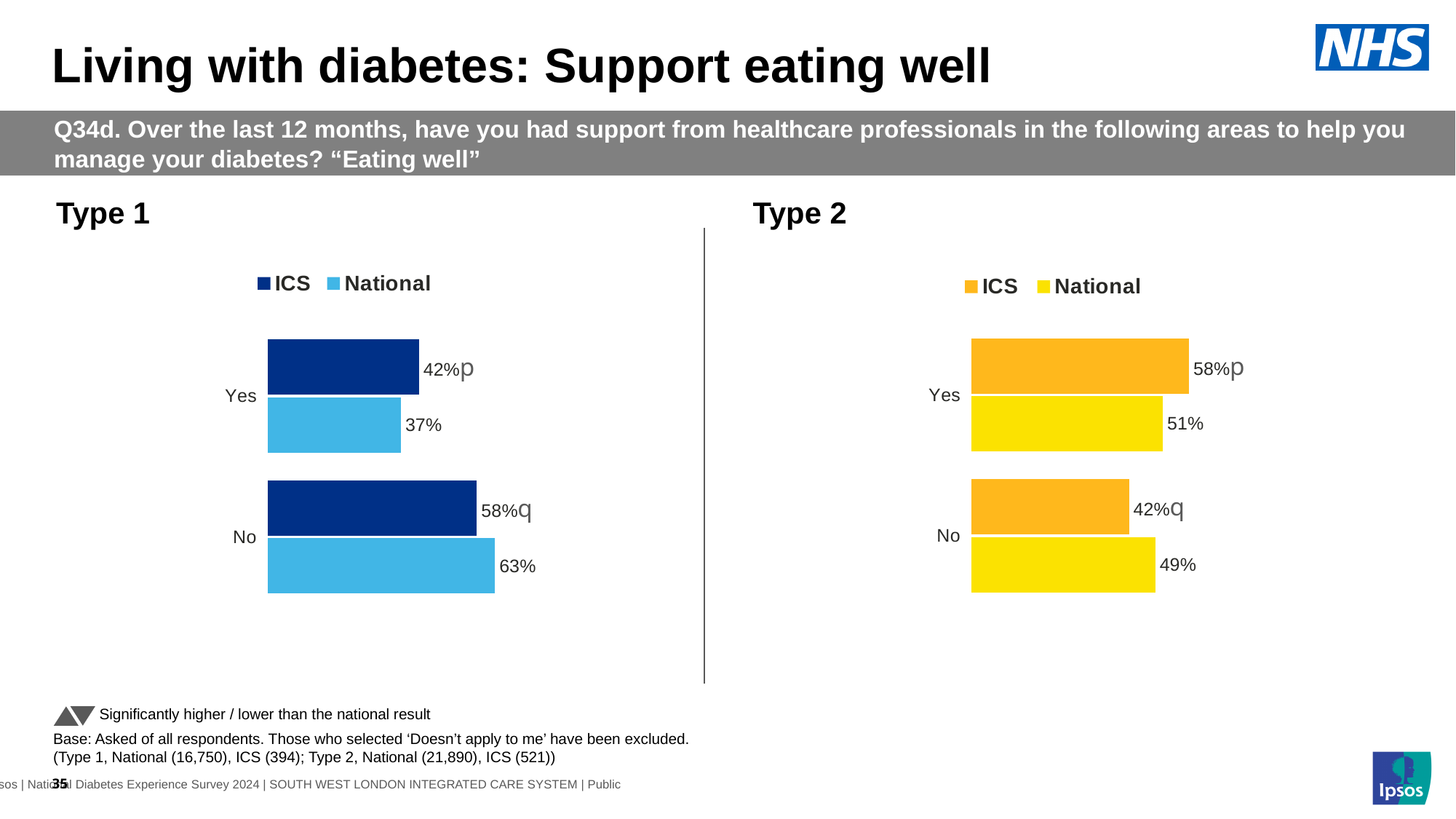
In the Type 2 chart, what is the difference between the National and ICS values for No? 7 percentage points In the Type 1 chart, which is larger for No: ICS or National? National What kind of chart is the Type 2 chart? Bar chart In the Type 1 chart, what is the National value for No? 63% How many series does the legend of the Type 2 chart list? 2 In the Type 2 chart, what is the ICS value for Yes? 58% In the Type 1 chart, what is the ICS value for Yes? 42% In the Type 2 chart, what is the National value for No? 49% How many categories are shown in the Type 1 chart? 2 In the Type 2 chart, which is larger for Yes: ICS or National? ICS In the Type 1 chart, which series has the highest value for No? National In the Type 1 chart, what is the difference between the ICS and National values for Yes? 5 percentage points